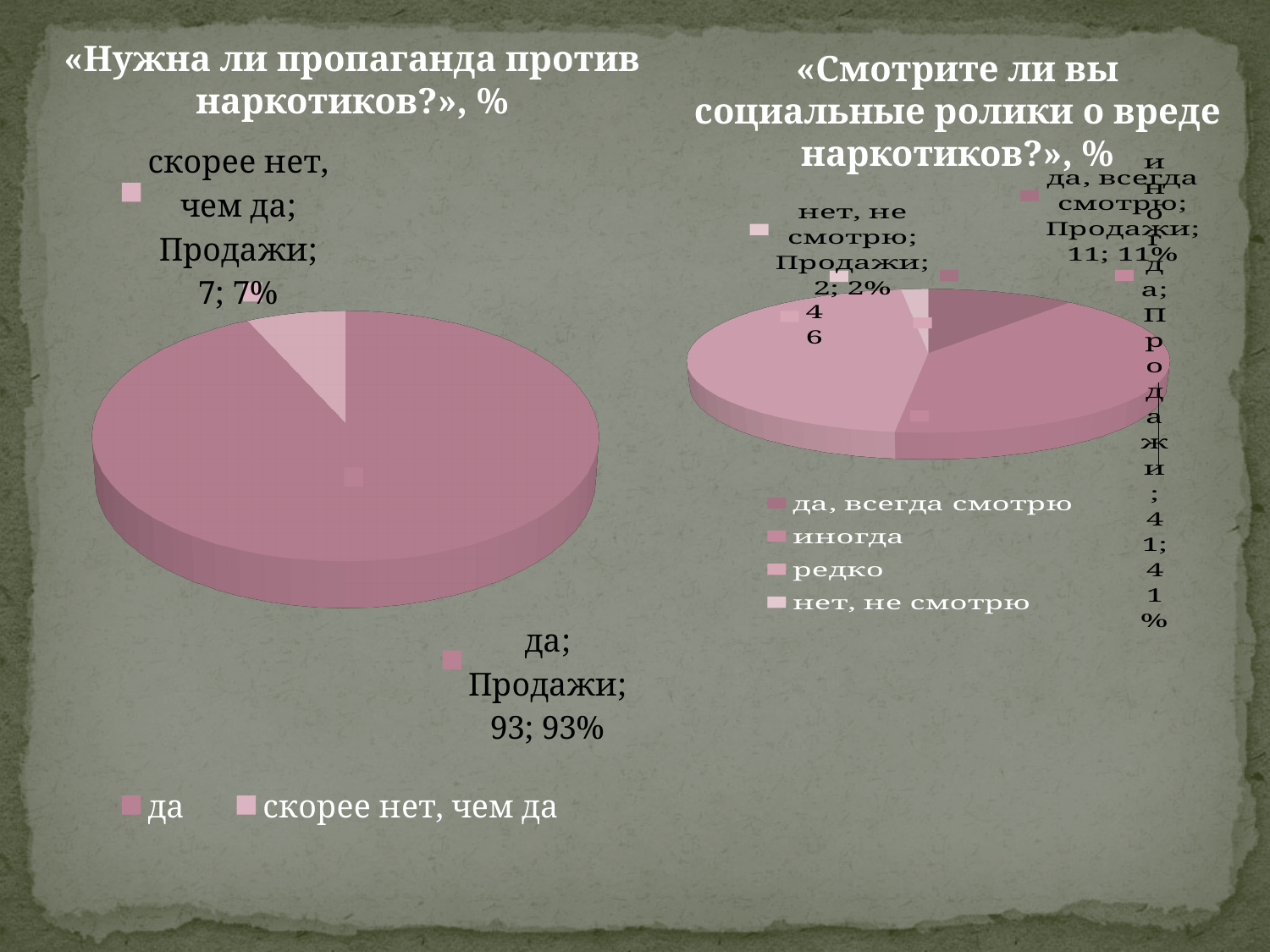
How many entries does the legend of the right chart «Смотрите ли вы социальные ролики о вреде наркотиков?» list? 4 In the left chart «Нужна ли пропаганда против наркотиков?», what percentage answered «скорее нет, чем да»? 7% In the right chart «Смотрите ли вы социальные ролики о вреде наркотиков?», what percentage answered «нет, не смотрю»? 2% In the right chart «Смотрите ли вы социальные ролики о вреде наркотиков?», what percentage answered «да, всегда смотрю»? 11% How many categories does the left chart «Нужна ли пропаганда против наркотиков?» show? 2 In the left chart «Нужна ли пропаганда против наркотиков?», which answer has the largest share? да What type of chart is the right chart «Смотрите ли вы социальные ролики о вреде наркотиков?»? pie chart In the left chart «Нужна ли пропаганда против наркотиков?», what is the difference in percentage points between «да» and «скорее нет, чем да»? 86 In the right chart «Смотрите ли вы социальные ролики о вреде наркотиков?», which answer has the smallest share? нет, не смотрю What type of chart is the left chart «Нужна ли пропаганда против наркотиков?»? pie chart In the right chart «Смотрите ли вы социальные ролики о вреде наркотиков?», which is larger: «да, всегда смотрю» or «нет, не смотрю»? да, всегда смотрю In the left chart «Нужна ли пропаганда против наркотиков?», what percentage answered «да»? 93%